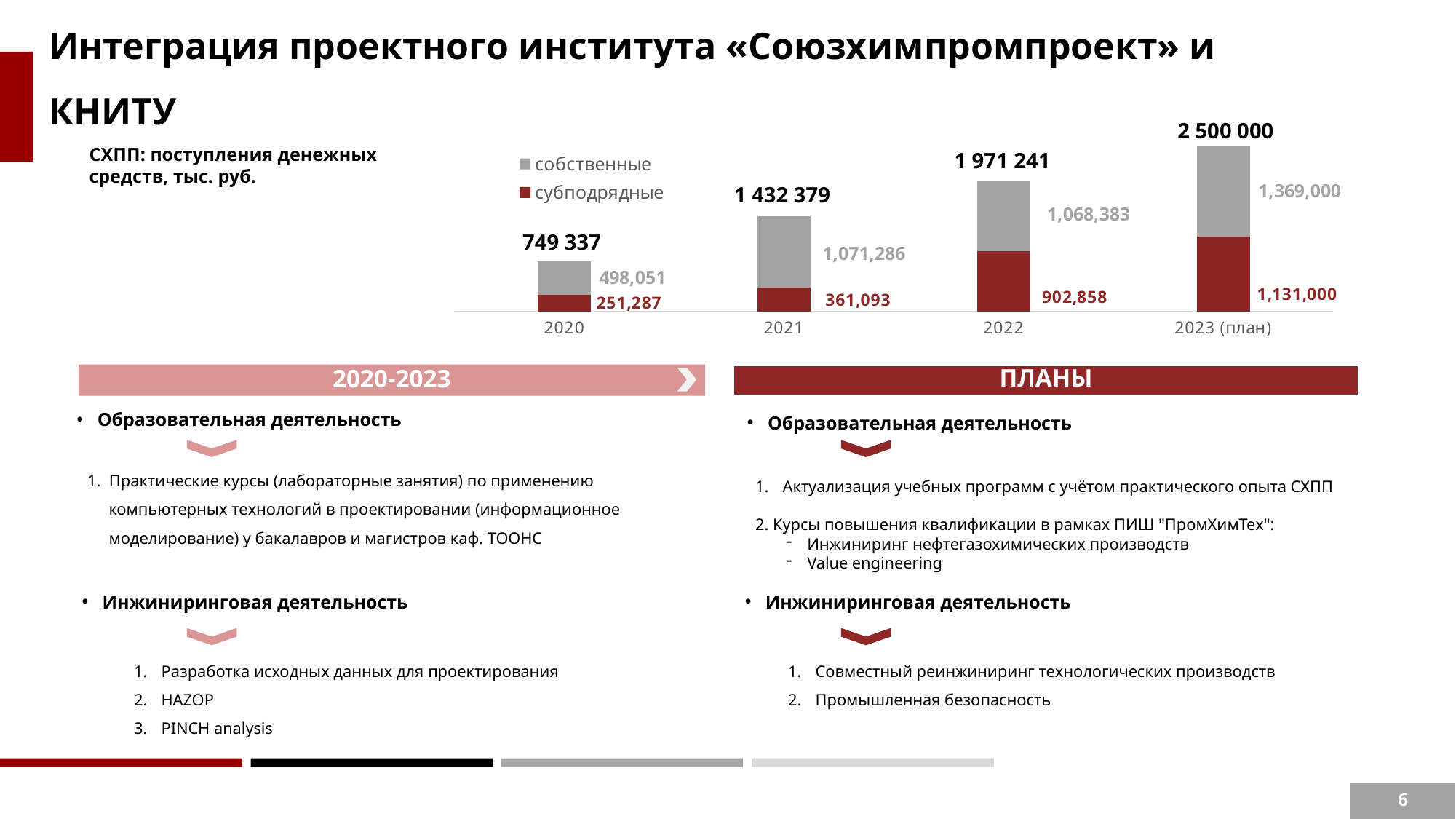
How many series does the chart legend list? 2 What kind of chart is shown on the slide? Stacked bar chart Which year has the lowest total value in the chart? 2020 How many categories (years) are shown on the x axis of the chart? 4 What is the difference between «собственные» and «субподрядные» for 2023 (план)? 238,000 Do the total values rise or fall from 2020 to 2023 (план)? Rise What is the total of the stacked bar for 2023 (план)? 2 500 000 Which year has the highest value for «субподрядные»? 2023 (план) What is the value of «субподрядные» for 2022? 902,858 What is the value of «субподрядные» for 2020? 251,287 What is the value of «собственные» for 2021? 1,071,286 Which is larger in 2022: «собственные» or «субподрядные»? собственные